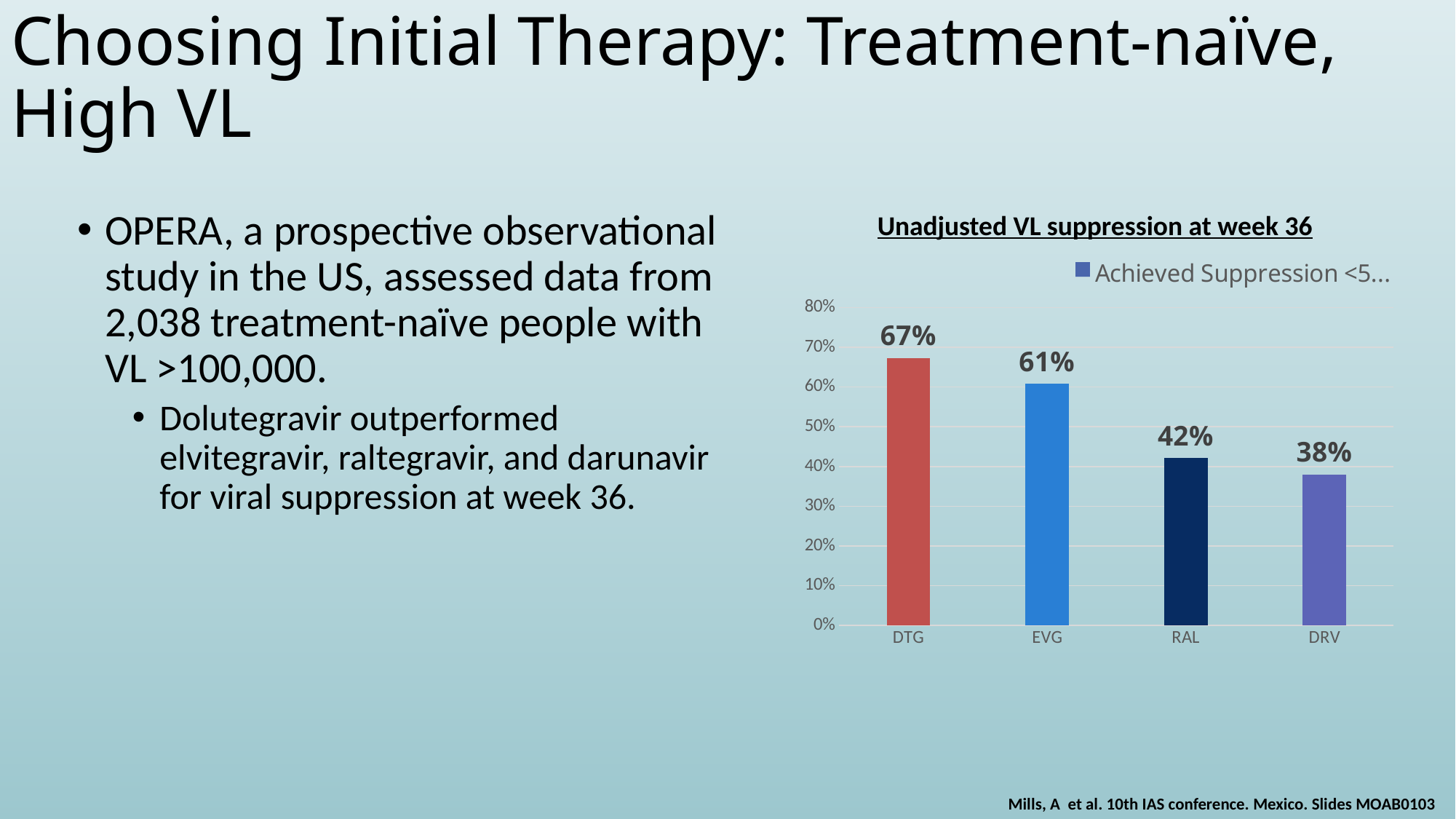
What is the value for DTG? 67% How many categories are shown on the x axis? 4 Which is larger, the value for EVG or the value for RAL? EVG What is the title of the chart? Unadjusted VL suppression at week 36 Which category has the lowest value? DRV What is the value for RAL? 42% Which category has the highest value? DTG What is the difference between the values for EVG and RAL? 19% What is the value for EVG? 61% What is the value for DRV? 38% What kind of chart is shown on the slide? Bar chart What is the difference between the values for DTG and DRV? 29%